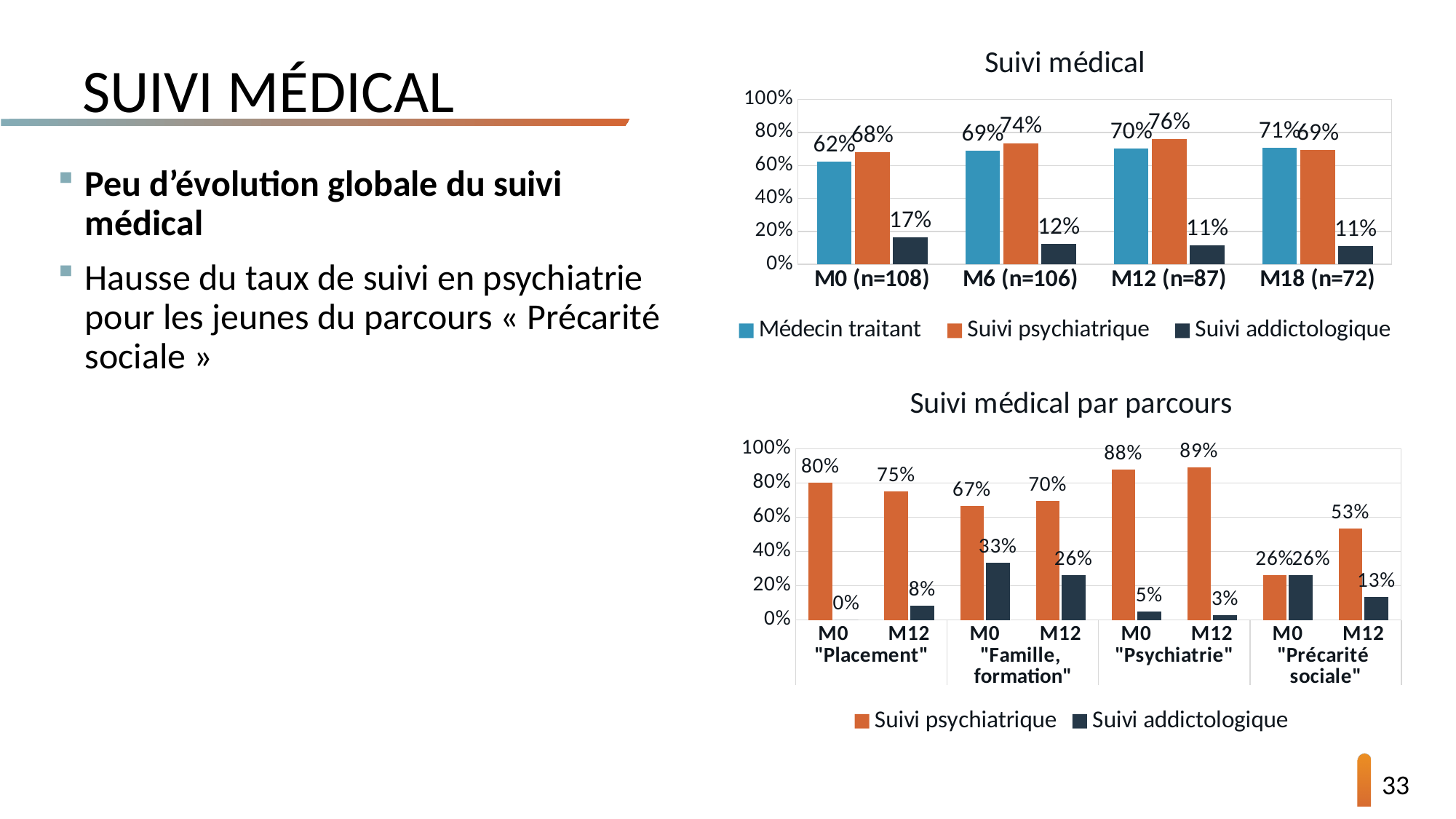
In the 'Suivi médical' chart, how many series does the legend list? 3 In the 'Suivi médical' chart, does the Suivi addictologique value rise or fall from M0 to M18? fall In the 'Suivi médical' chart, what is the value for Suivi addictologique at M0 (n=108)? 17% In the 'Suivi médical par parcours' chart, what is the difference in Suivi psychiatrique between M12 and M0 'Précarité sociale'? 27% In the 'Suivi médical par parcours' chart, what is the Suivi addictologique value at M0 'Famille, formation'? 33% What type of chart is 'Suivi médical par parcours'? bar chart In the 'Suivi médical' chart, what is the value for Suivi psychiatrique at M12 (n=87)? 76% In the 'Suivi médical par parcours' chart, which category has the highest Suivi psychiatrique value? M12 "Psychiatrie" In the 'Suivi médical par parcours' chart, what is the Suivi psychiatrique value at M12 'Précarité sociale'? 53% In the 'Suivi médical' chart, what is the value for Médecin traitant at M0 (n=108)? 62% In the 'Suivi médical par parcours' chart, which category has the lowest Suivi addictologique value? M0 "Placement" In the 'Suivi médical' chart, what is the difference between Suivi psychiatrique and Médecin traitant at M6 (n=106)? 5%